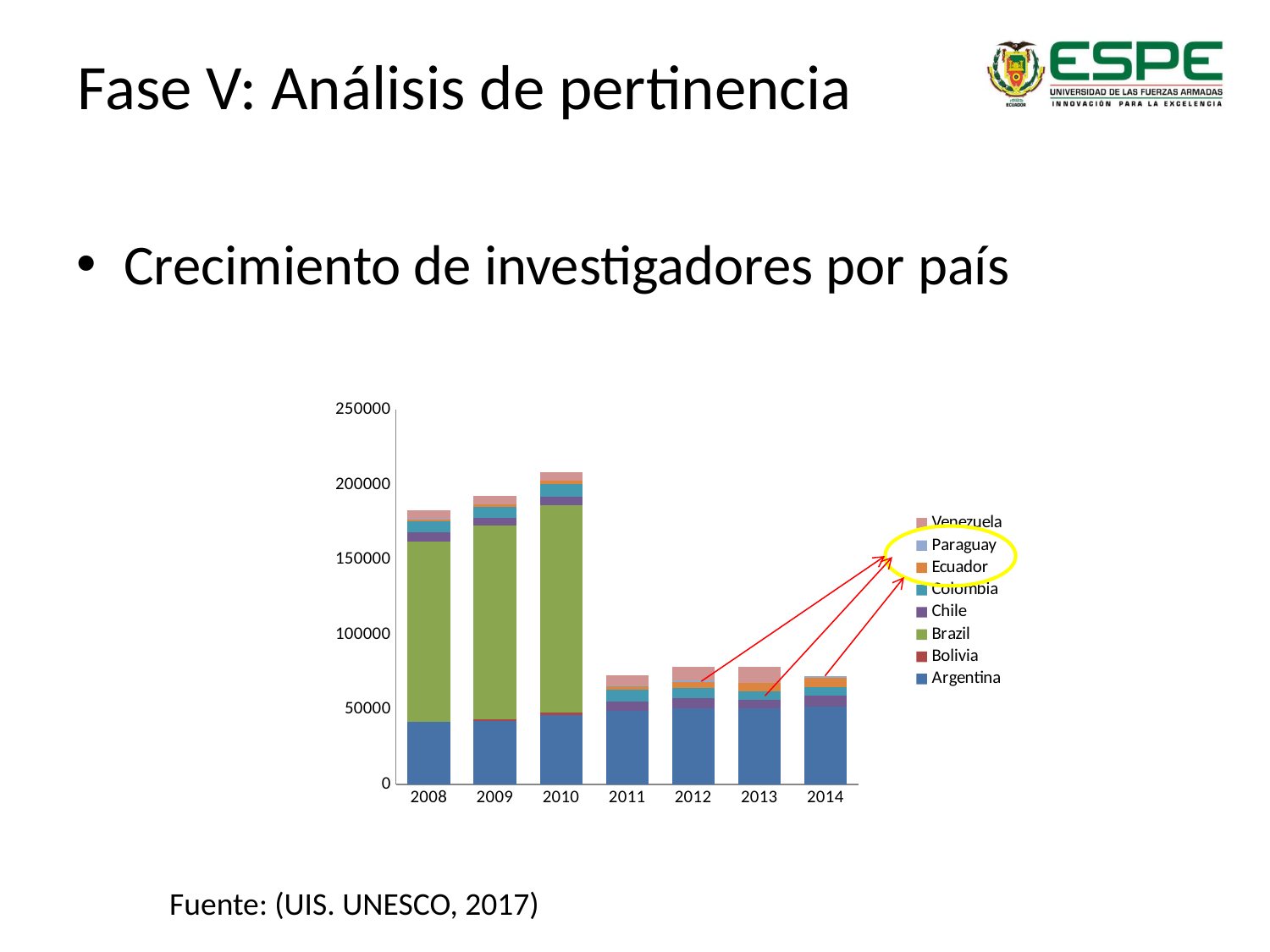
Which series is shown in green in the chart's legend? Brazil Is the total for 2011 greater or less than 50000? greater Is the total for 2012 greater or less than 100000? less Which series is listed last in the chart's legend? Argentina What kind of chart is shown on the slide? stacked bar chart How many years are shown on the x axis of the chart? 7 How many series does the chart's legend list? 8 Do the total bars rise or fall from 2008 to 2010? rise Is the total for 2010 greater or less than 200000? greater Which year has the highest total bar in the chart? 2010 Which year has the larger total bar, 2010 or 2011? 2010